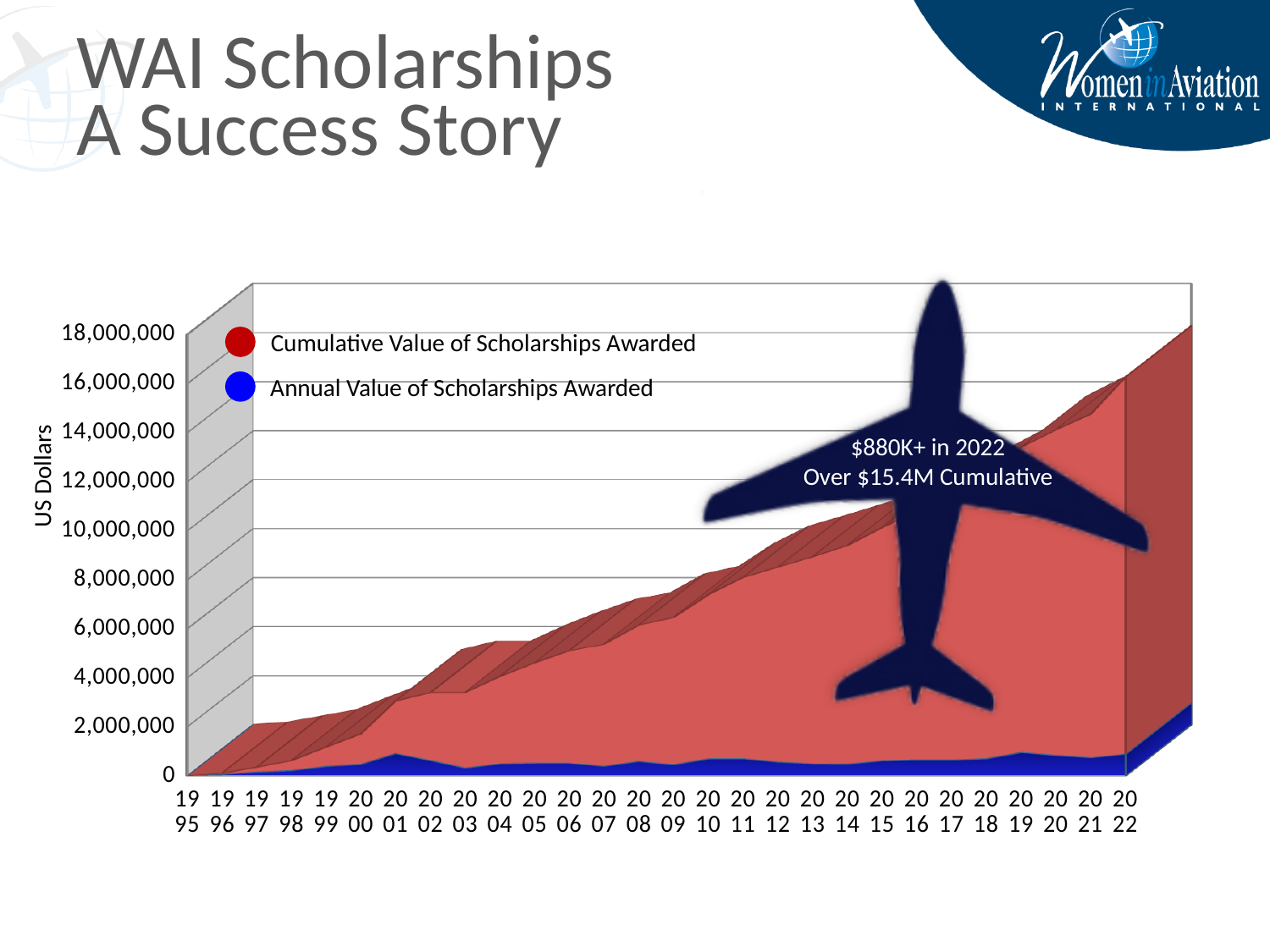
In which year is the Cumulative Value of Scholarships Awarded lowest? 1995 How many years are shown along the x axis of the chart? 28 Is the Cumulative Value of Scholarships Awarded in 2022 greater or less than 12,000,000? greater What is the label on the vertical axis of the chart? US Dollars What kind of chart is shown on the slide? Area chart In 2015, which is larger: the Cumulative Value of Scholarships Awarded or the Annual Value of Scholarships Awarded? Cumulative Value of Scholarships Awarded Does the Cumulative Value of Scholarships Awarded rise or fall from 1995 to 2022? Rise How many series does the chart legend list? 2 What is the first year shown on the x axis? 1995 In which year is the Cumulative Value of Scholarships Awarded highest? 2022 Is the Cumulative Value of Scholarships Awarded in 2010 greater or less than 10,000,000? less Is the Annual Value of Scholarships Awarded in 2022 greater or less than 4,000,000? less